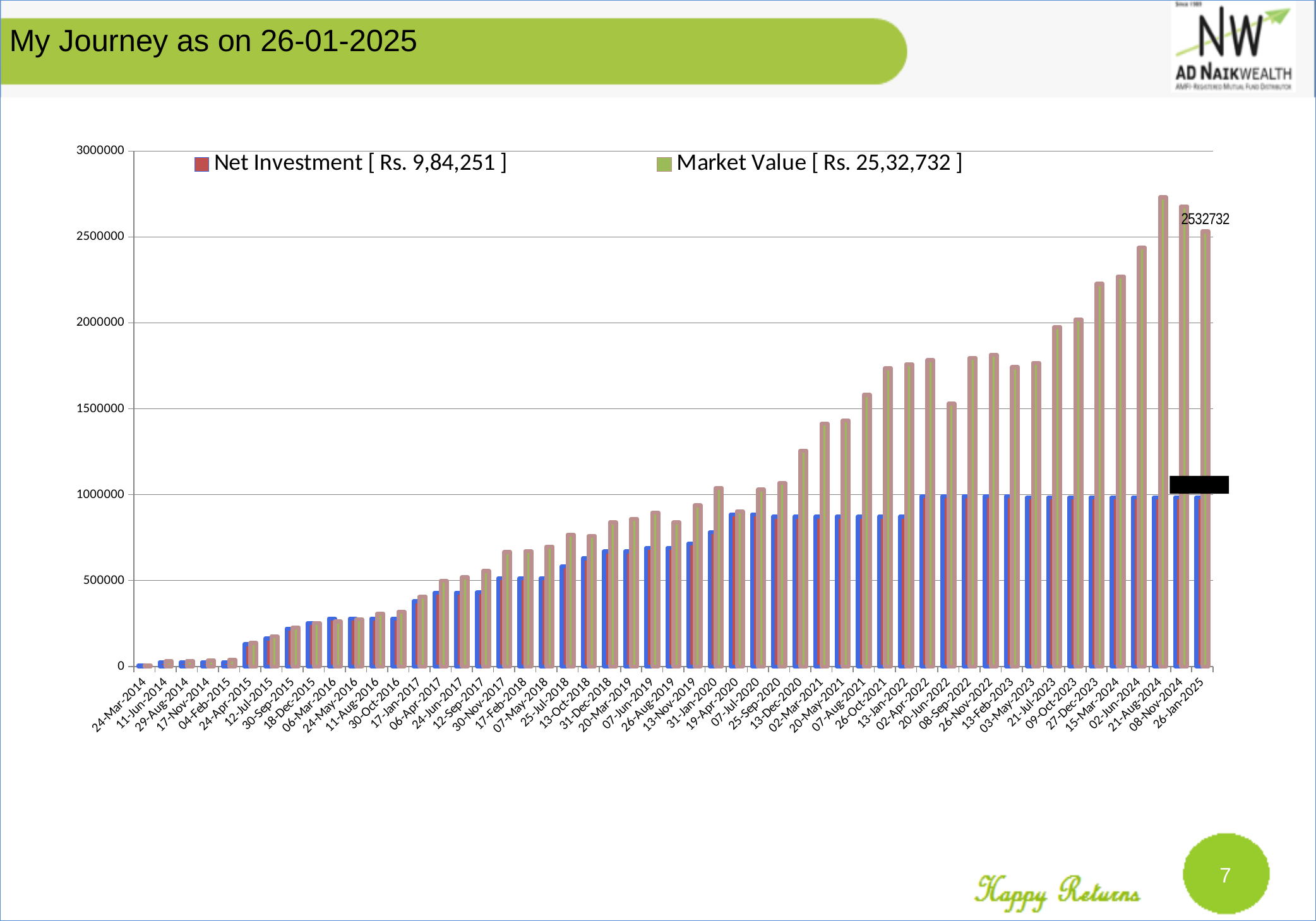
Is the Market Value for 26-Jan-2025 greater or less than 2500000? greater Is the Market Value for 02-Jun-2024 greater or less than 2500000? less What Market Value amount is shown in the legend? Rs. 25,32,732 What is the Market Value on 26-Jan-2025 according to the data label? 2532732 Is the Market Value for 26-Oct-2021 greater or less than 1500000? greater Does the Market Value generally rise or fall from 24-Mar-2014 to 26-Jan-2025? rise On which date is the Market Value bar highest? 21-Aug-2024 What kind of chart is shown on the slide? bar chart On 26-Jan-2025, which is larger: Net Investment or Market Value? Market Value What Net Investment amount is shown in the legend? Rs. 9,84,251 How many series does the chart legend list? 2 On which date is the Market Value bar lowest? 24-Mar-2014